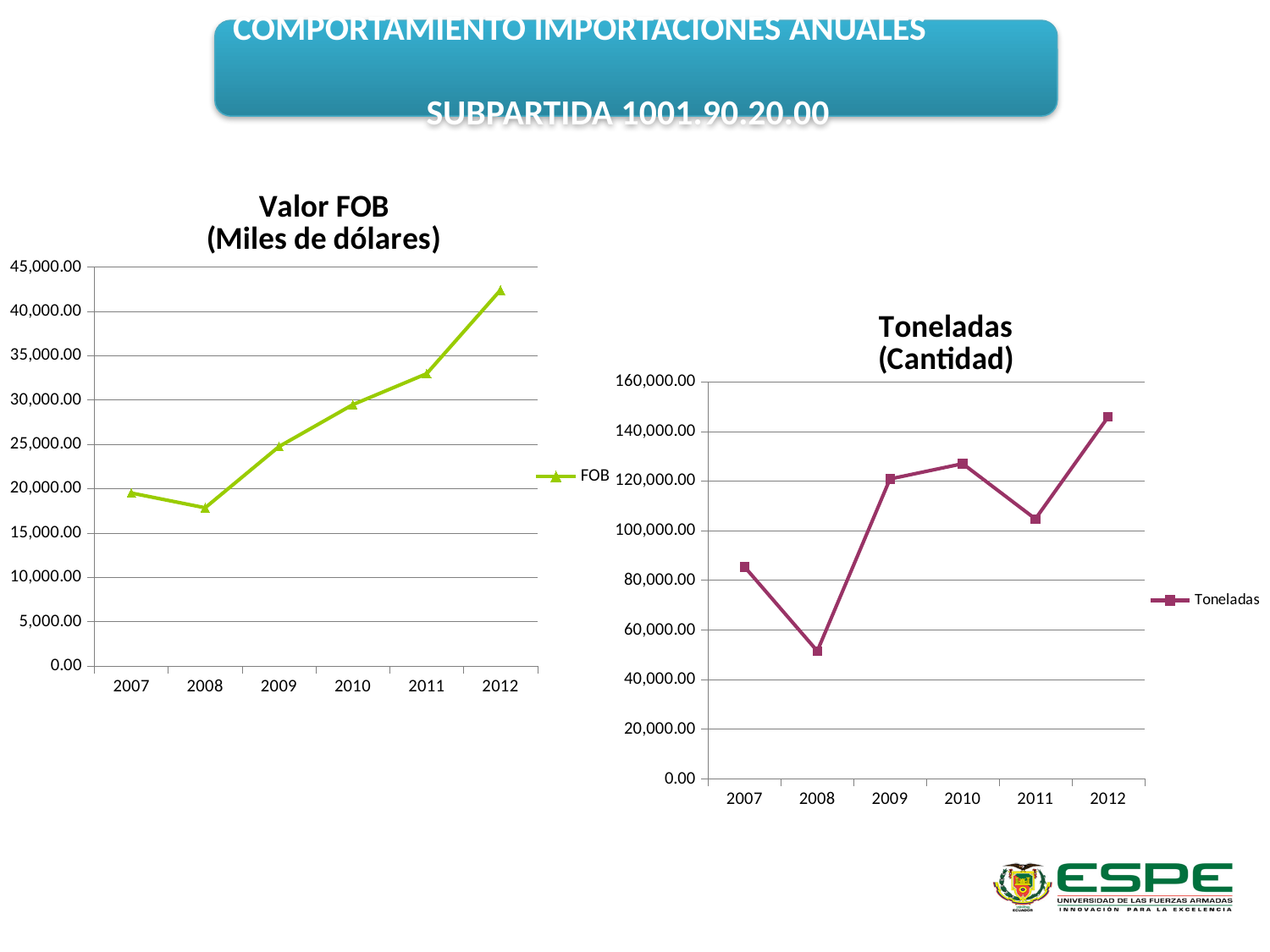
In the "Valor FOB (Miles de dólares)" chart, is the value for 2012 greater or less than 40,000.00? greater How many series does the legend of the "Toneladas (Cantidad)" chart list? 1 In the "Toneladas (Cantidad)" chart, which year has the highest value? 2012 In the "Valor FOB (Miles de dólares)" chart, which year has the highest value? 2012 In the "Valor FOB (Miles de dólares)" chart, which year has the lowest value? 2008 In the "Toneladas (Cantidad)" chart, do the values rise or fall from 2008 to 2009? rise What kind of chart is the "Valor FOB (Miles de dólares)" chart? line chart In the "Valor FOB (Miles de dólares)" chart, is the value for 2008 greater or less than 20,000.00? less How many years are plotted on the x axis of the "Valor FOB (Miles de dólares)" chart? 6 In the "Toneladas (Cantidad)" chart, is the value for 2008 greater or less than 60,000.00? less In the "Toneladas (Cantidad)" chart, which is larger, the value for 2010 or the value for 2011? 2010 In the "Toneladas (Cantidad)" chart, which year has the lowest value? 2008